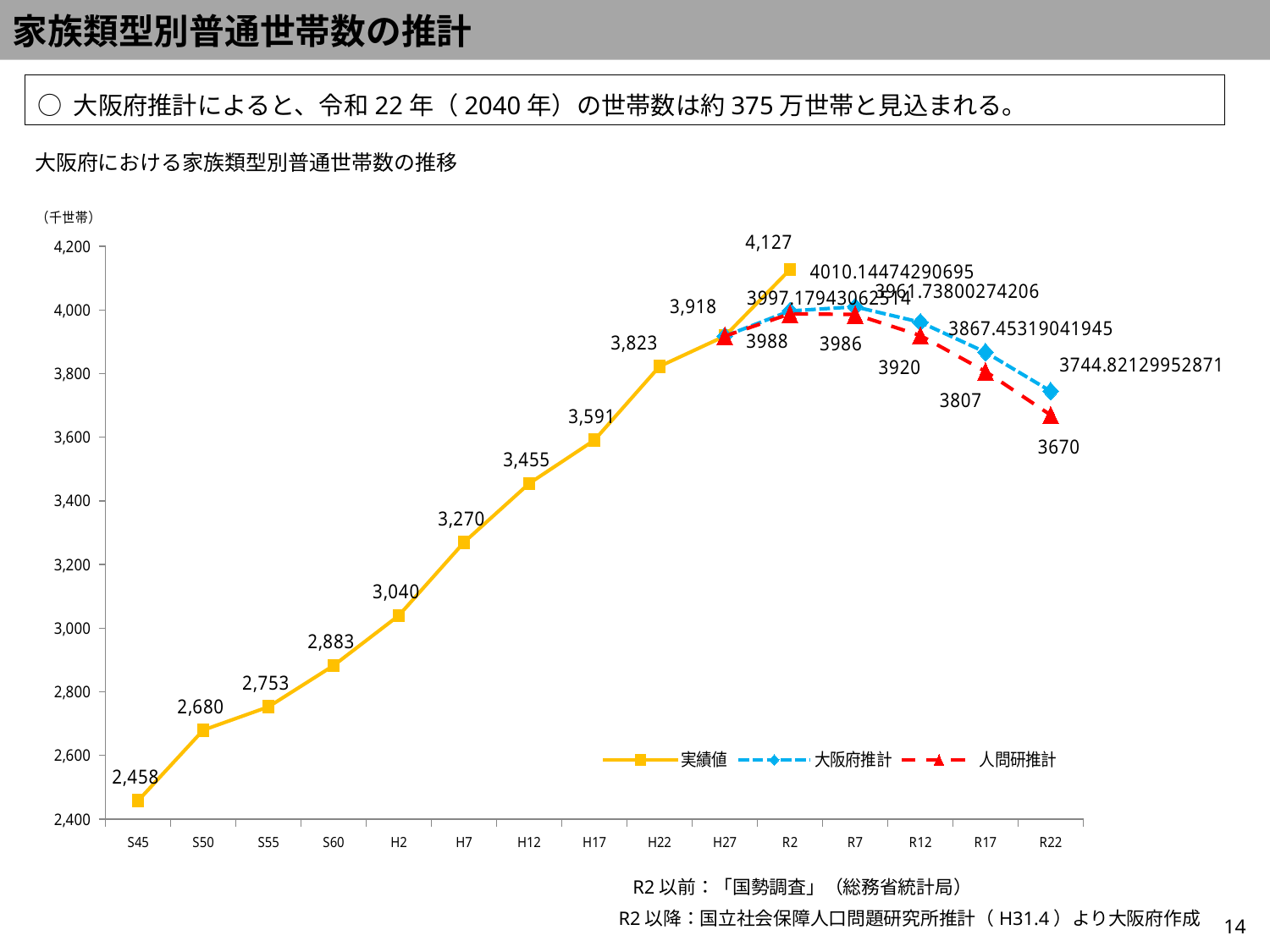
What is the 大阪府推計 value for R22? 3744.82129952871 What is the 実績値 value for S45? 2,458 At which x-axis category is the 実績値 series lowest? S45 What is the 実績値 value for H22? 3,823 What is the difference between the 実績値 values for H27 and H22? 95 Does the 実績値 series rise or fall from S45 to R2? Rise At R22, which series has the larger value, 大阪府推計 or 人問研推計? 大阪府推計 At which x-axis category does the 実績値 series reach its highest value? R2 What kind of chart is shown on the slide? Line chart What is the 人問研推計 value for R22? 3670 What is the difference between the 人問研推計 values for R17 and R22? 137 How many series does the legend list? 3